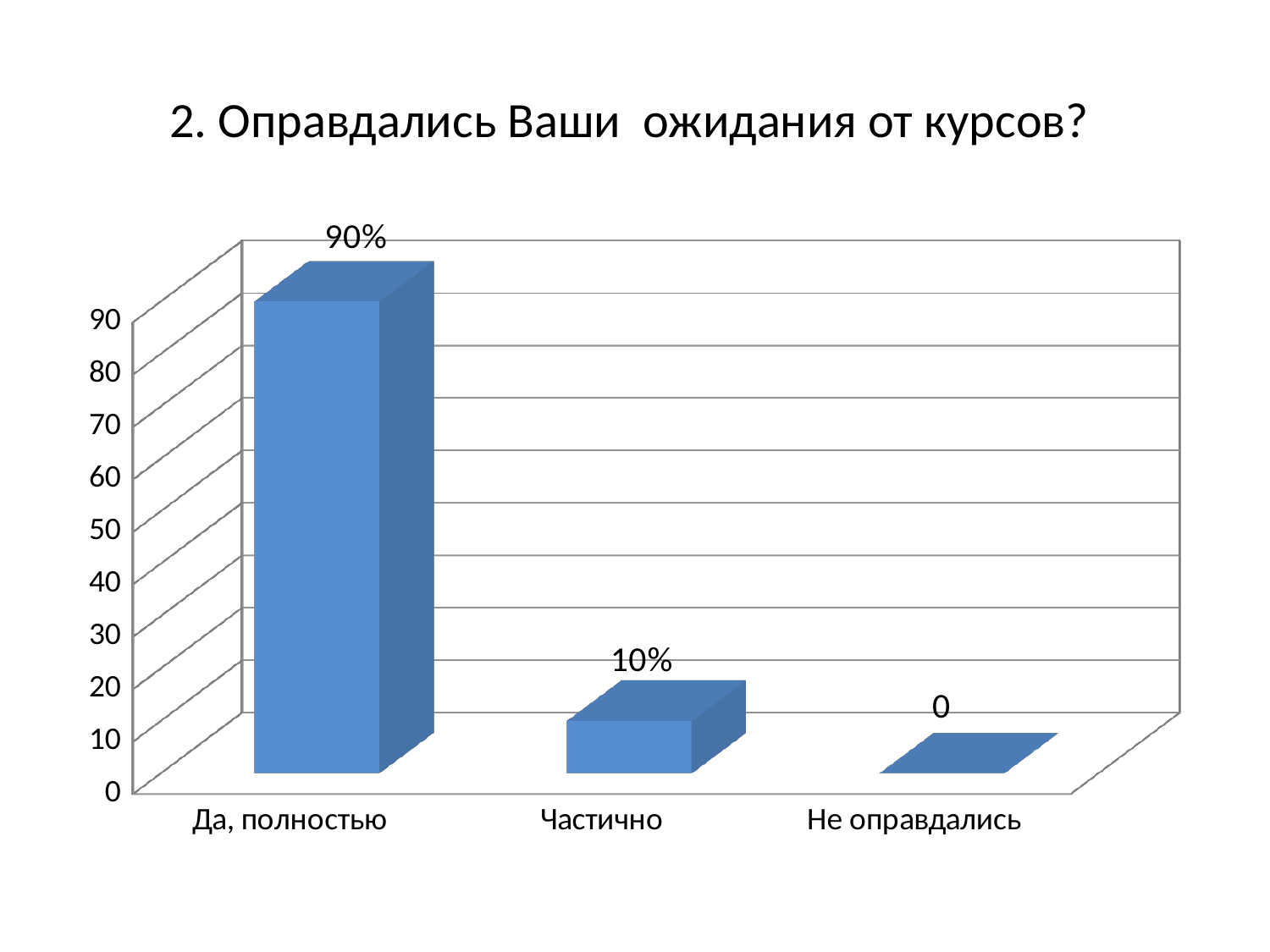
What is the difference between the values for "Да, полностью" and "Частично"? 80% Which category has the lowest value? Не оправдались What is the value for "Частично"? 10% Which category has the highest value? Да, полностью What kind of chart is shown on the slide? bar chart What is the title of the slide? 2. Оправдались Ваши ожидания от курсов? Is the value for "Да, полностью" greater or less than 50? greater Which is larger, the value for "Частично" or the value for "Не оправдались"? Частично How many categories are shown on the x axis? 3 What is the value for "Да, полностью"? 90% Do the values rise or fall from left to right along the x axis? fall What is the value for "Не оправдались"? 0